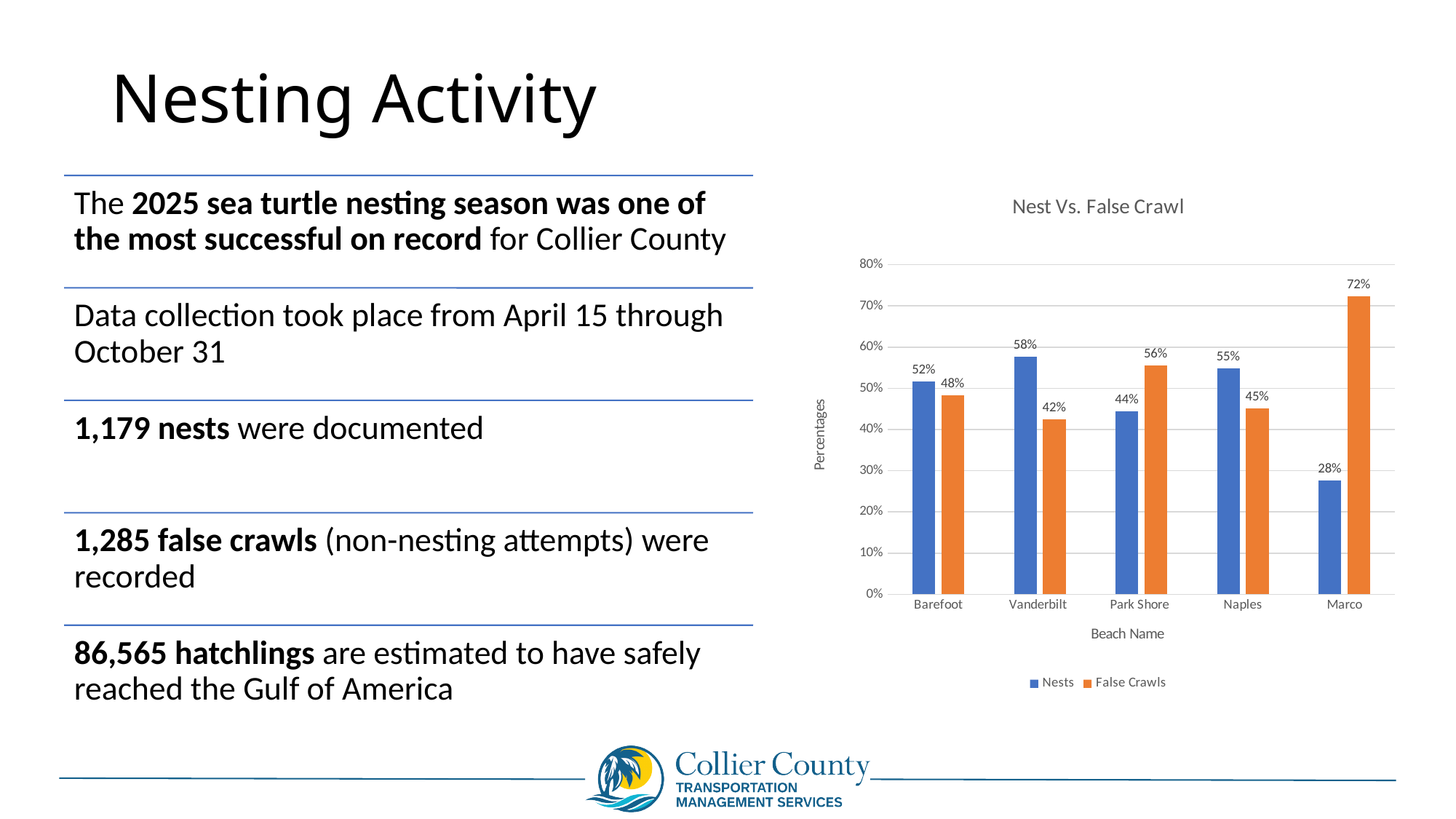
How many series does the legend list? 2 Which beach has the highest False Crawls value? Marco What is the False Crawls value for Marco? 72% What is the Nests value for Park Shore? 44% Which is larger for Naples, the Nests value or the False Crawls value? Nests How many beaches are shown on the x axis? 5 Which beach has the lowest Nests value? Marco Is the Nests value for Barefoot greater or less than 40%? greater What is the title of the chart? Nest Vs. False Crawl What kind of chart is shown on the slide? Bar chart What is the Nests value for Vanderbilt? 58% What is the difference between the False Crawls and Nests values for Marco? 44%